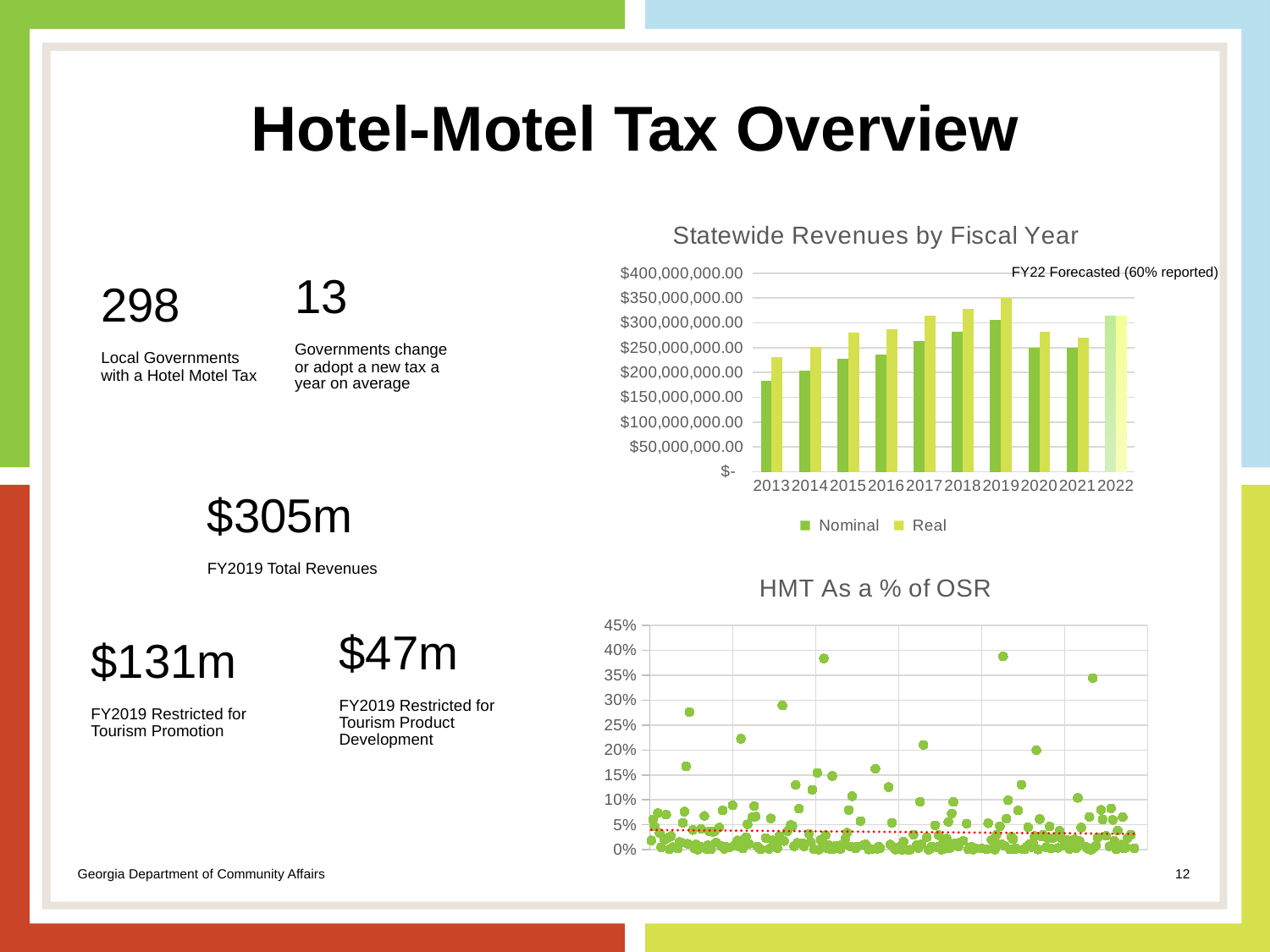
In the 'Statewide Revenues by Fiscal Year' chart, is the Real value for 2019 greater or less than $300,000,000.00? greater In the 'Statewide Revenues by Fiscal Year' chart, do Nominal revenues rise or fall from 2013 to 2019? Rise How many series does the legend of the 'Statewide Revenues by Fiscal Year' chart list? 2 In the 'Statewide Revenues by Fiscal Year' chart, is the Nominal value for 2013 greater or less than $200,000,000.00? less In the 'Statewide Revenues by Fiscal Year' chart, is the Real value for 2013 greater or less than $200,000,000.00? greater How many fiscal years are shown on the x axis of the 'Statewide Revenues by Fiscal Year' chart? 10 In the 'Statewide Revenues by Fiscal Year' chart, which fiscal year has the highest Real revenue? 2019 What kind of chart is the 'Statewide Revenues by Fiscal Year' chart? Bar chart In the 'Statewide Revenues by Fiscal Year' chart, which fiscal year has the lowest Nominal revenue? 2013 What annotation appears at the top right of the 'Statewide Revenues by Fiscal Year' chart? FY22 Forecasted (60% reported) In the 'Statewide Revenues by Fiscal Year' chart, which is larger for 2015, the Nominal or the Real value? Real What kind of chart is the 'HMT As a % of OSR' chart? Scatter chart